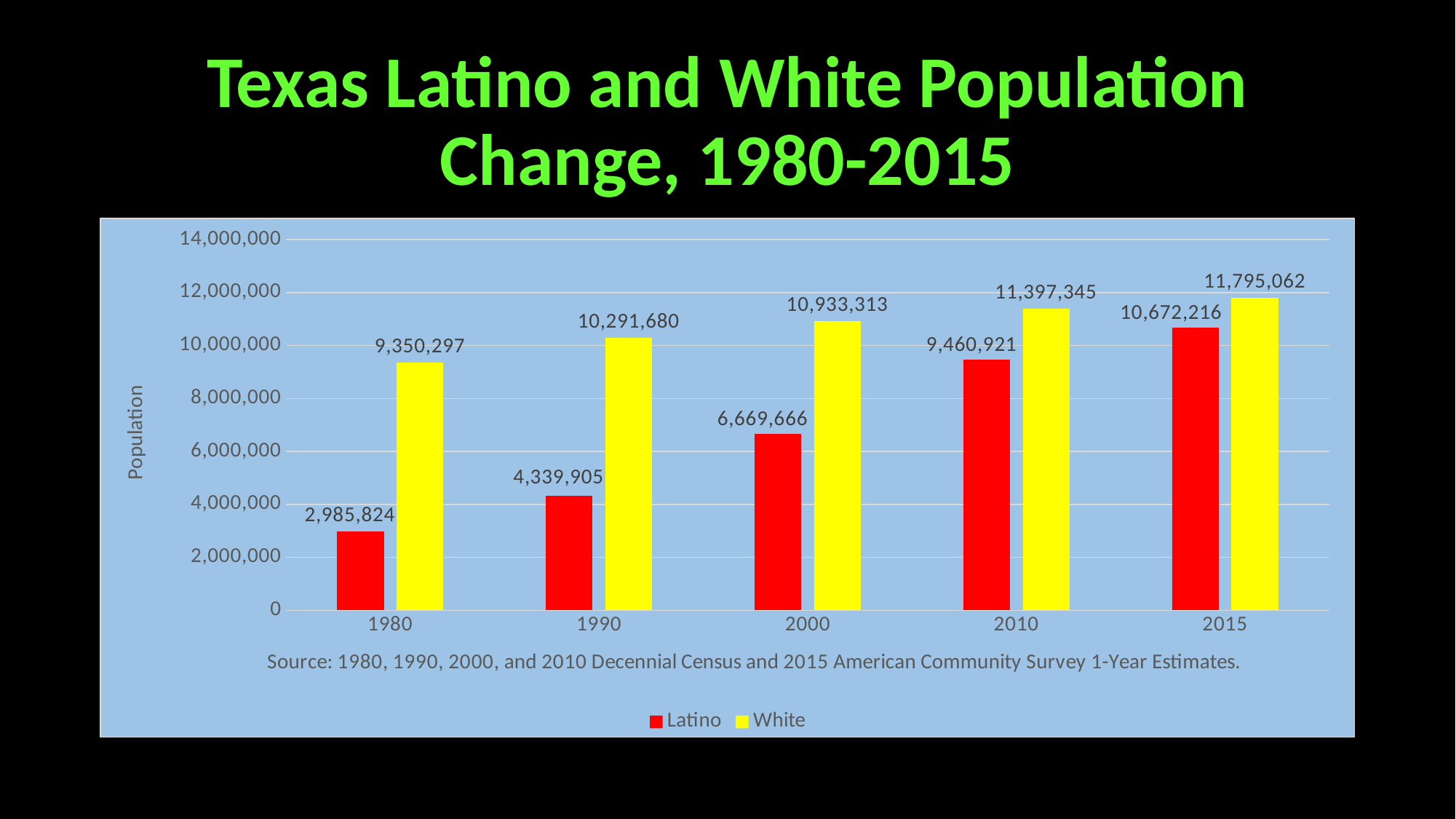
In which year is the White population lowest? 1980 What is the difference between the White and Latino populations in 2015? 1,122,846 In which year is the Latino population highest? 2015 What is the White population in 2015? 11,795,062 What is the White population in 2000? 10,933,313 How many years are shown on the x axis? 5 What is the Latino population in 2010? 9,460,921 How many series does the legend list? 2 By how much did the Latino population grow from 1980 to 2015? 7,686,392 What is the Latino population in 1980? 2,985,824 Which is larger in 1990, the Latino population or the White population? White What kind of chart is shown on the slide? Bar chart